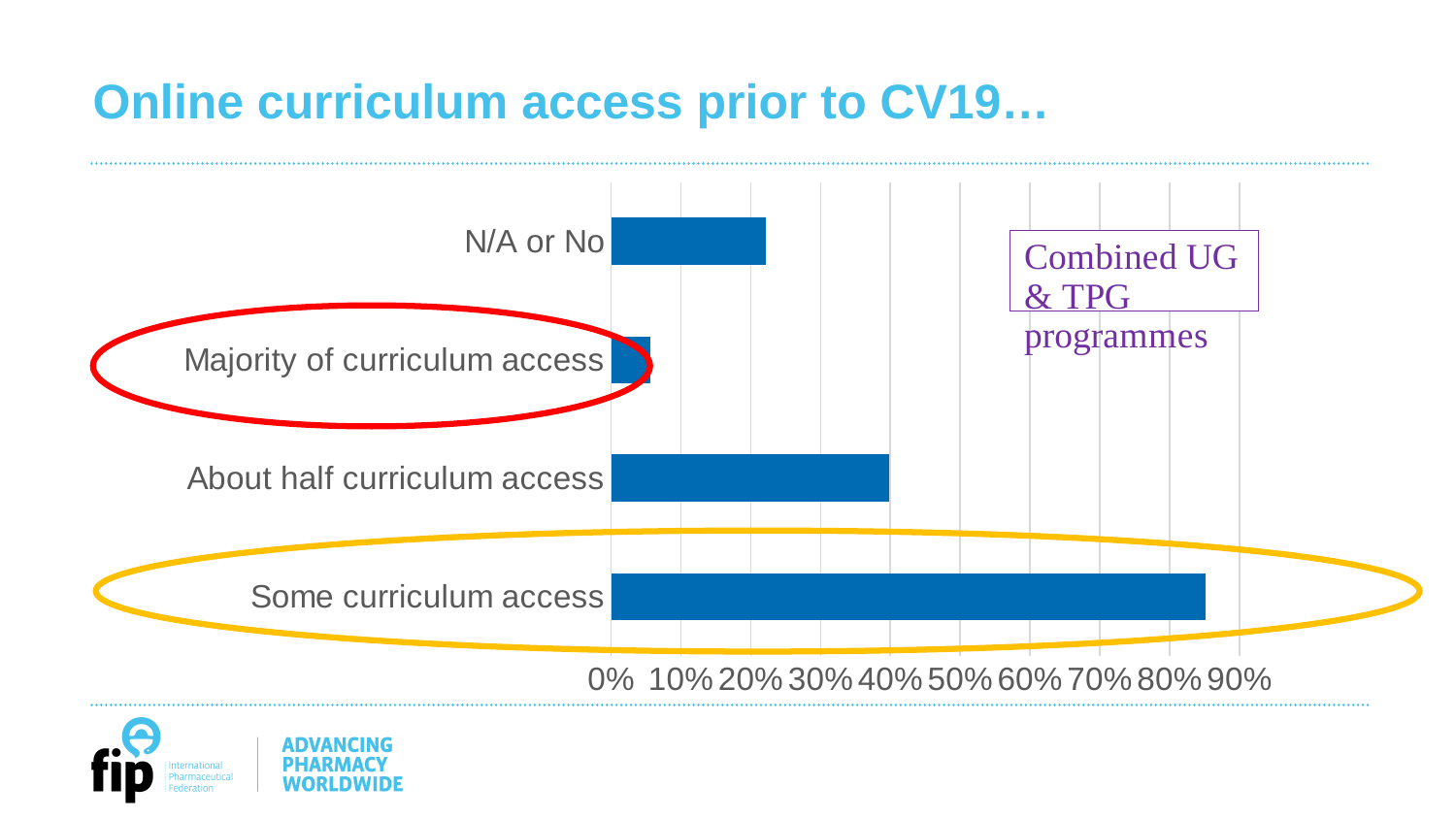
Is the value for N/A or No greater or less than 10%? greater Which category has the highest value? Some curriculum access Is the value for Some curriculum access greater or less than 80%? greater Which is larger, the value for N/A or No or the value for Majority of curriculum access? N/A or No Which is larger, the value for N/A or No or the value for About half curriculum access? About half curriculum access Is the value for N/A or No greater or less than 30%? less What kind of chart is shown on the slide? bar chart What is the title of the slide containing the chart? Online curriculum access prior to CV19… How many categories are plotted in the chart? 4 Which category has the lowest value? Majority of curriculum access